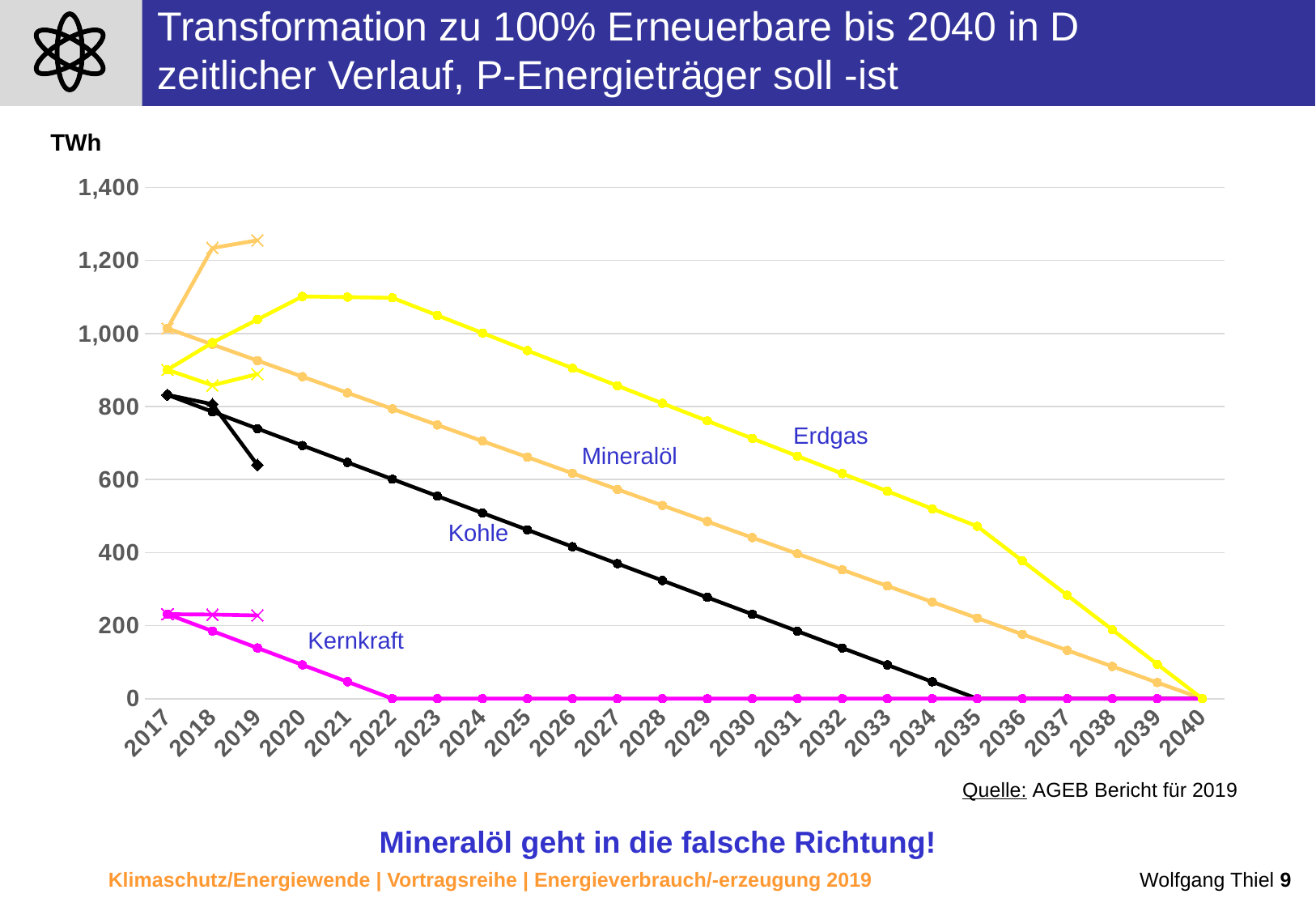
Is the planned (soll) value for Erdgas in 2035 greater or less than 600? less What is the planned (soll) value for Kohle in 2035? 0 What kind of chart is shown on the slide? line chart What unit is shown on the y axis of the chart? TWh Is the planned (soll) value for Erdgas in 2020 greater or less than 1,000? greater What is the planned (soll) value for Kernkraft in 2022? 0 How many years are shown along the x axis of the chart? 24 Does the planned (soll) line for Kohle rise or fall from 2017 to 2035? fall In 2025, which planned (soll) value is larger: Erdgas or Mineralöl? Erdgas Which energy source has the highest planned (soll) value in 2030? Erdgas Is the actual (ist) value for Mineralöl in 2019 greater or less than 1,200? greater What is the planned (soll) value for Erdgas in 2040? 0